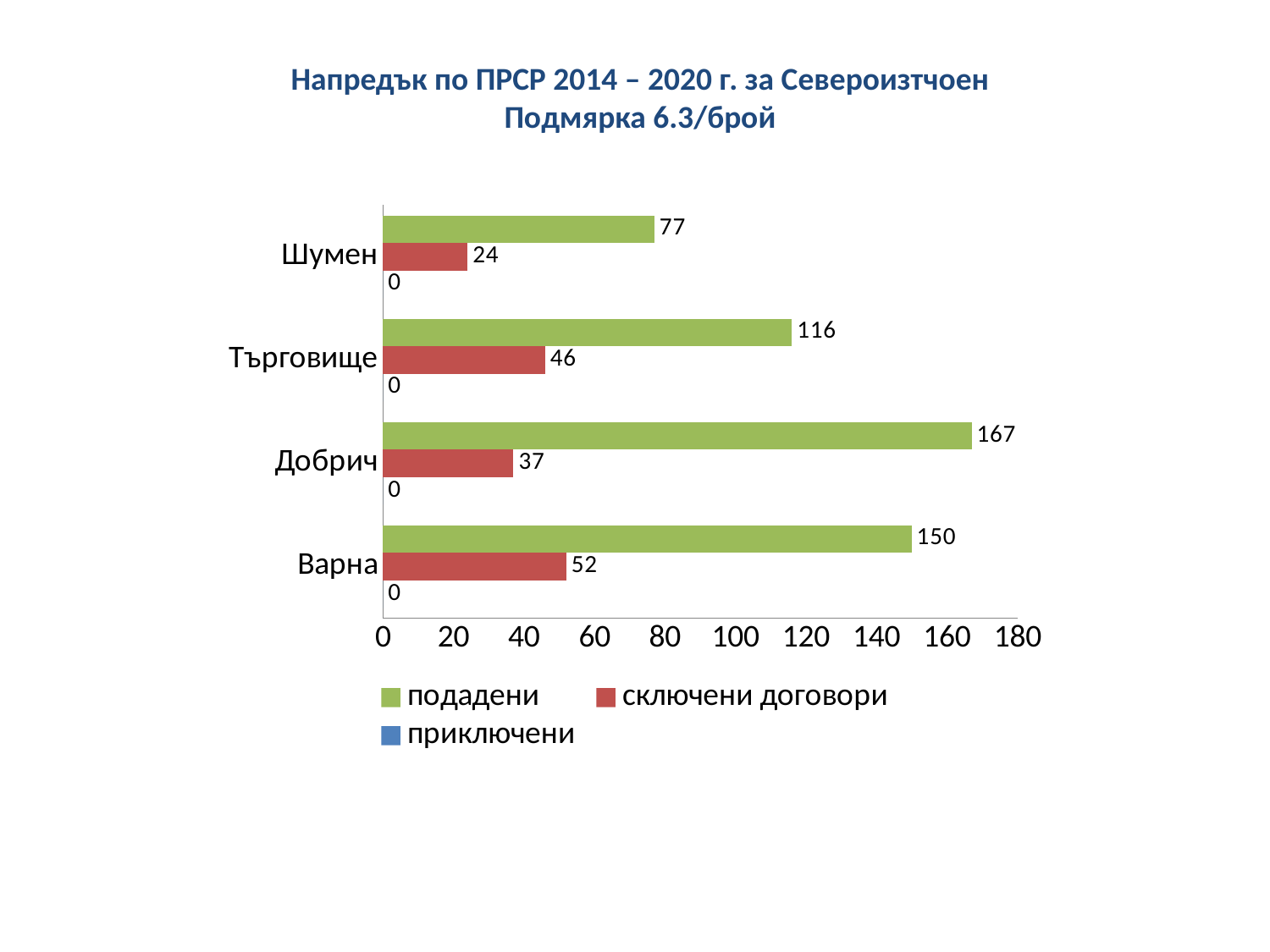
What is the value of "подадени" for Добрич? 167 How many categories are shown on the chart? 4 What is the difference between "подадени" and "сключени договори" for Търговище? 70 Which is larger: "сключени договори" for Варна or for Търговище? Варна Which category has the highest value for "подадени"? Добрич What colour represents the "сключени договори" series? red What kind of chart is shown on the slide? bar chart How many series does the legend list? 3 What is the value of "приключени" for Шумен? 0 What is the value of "сключени договори" for Варна? 52 Which category has the lowest value for "сключени договори"? Шумен Is the value of "подадени" for Шумен greater or less than 80? less